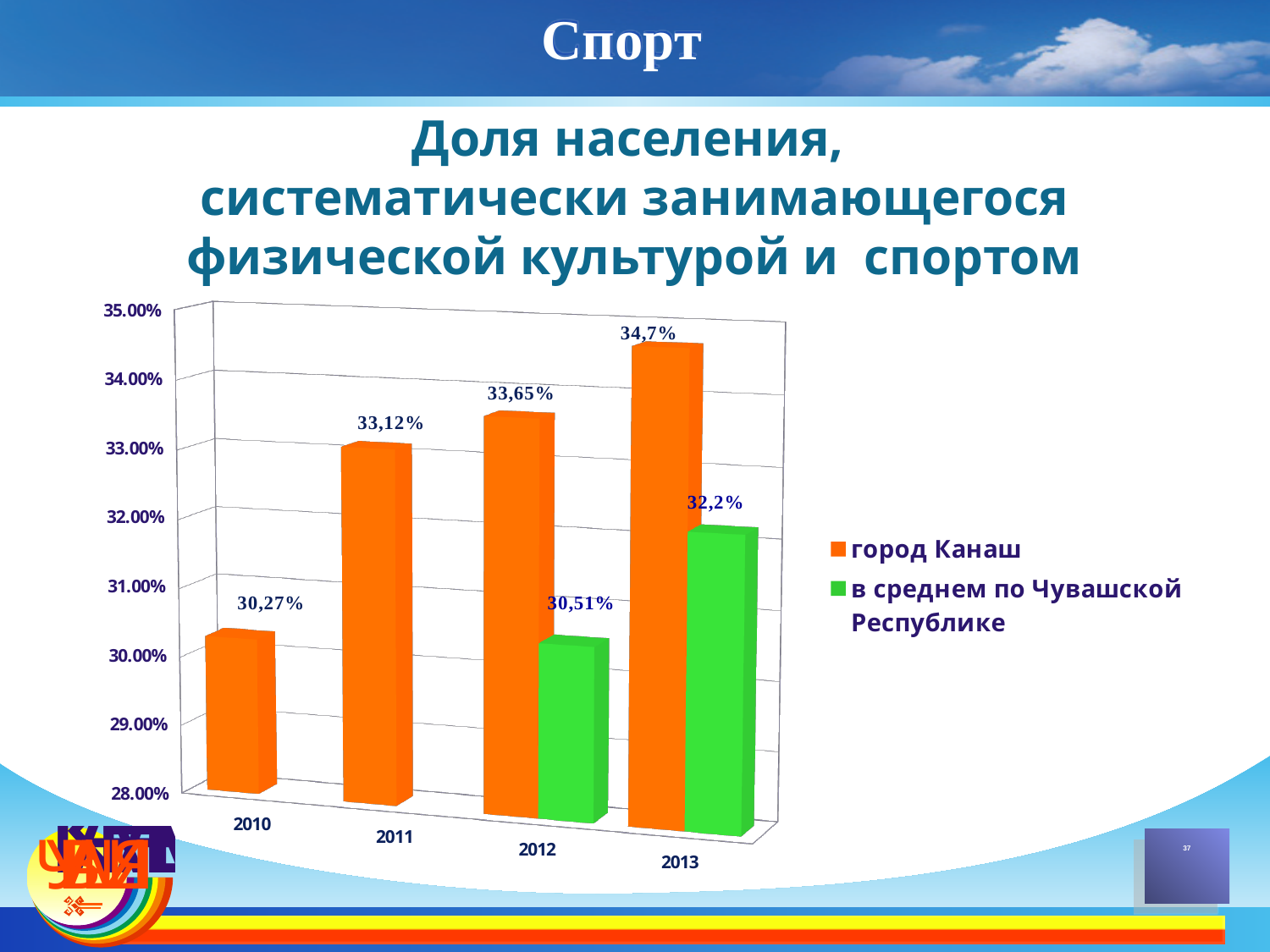
What is the value for город Канаш in 2013? 34,7% What is the value for в среднем по Чувашской Республике in 2013? 32,2% What is the value for город Канаш in 2010? 30,27% What is the value for в среднем по Чувашской Республике in 2012? 30,51% Is the value for город Канаш in 2011 greater or less than 32.00%? greater In which year is the value for город Канаш highest? 2013 How many years are shown on the x axis? 4 Which is larger in 2012: город Канаш or в среднем по Чувашской Республике? город Канаш What is the difference between город Канаш and в среднем по Чувашской Республике in 2013? 2,5 percentage points How many series does the legend list? 2 In which year is the value for город Канаш lowest? 2010 Do the values for город Канаш rise or fall from 2010 to 2013? rise